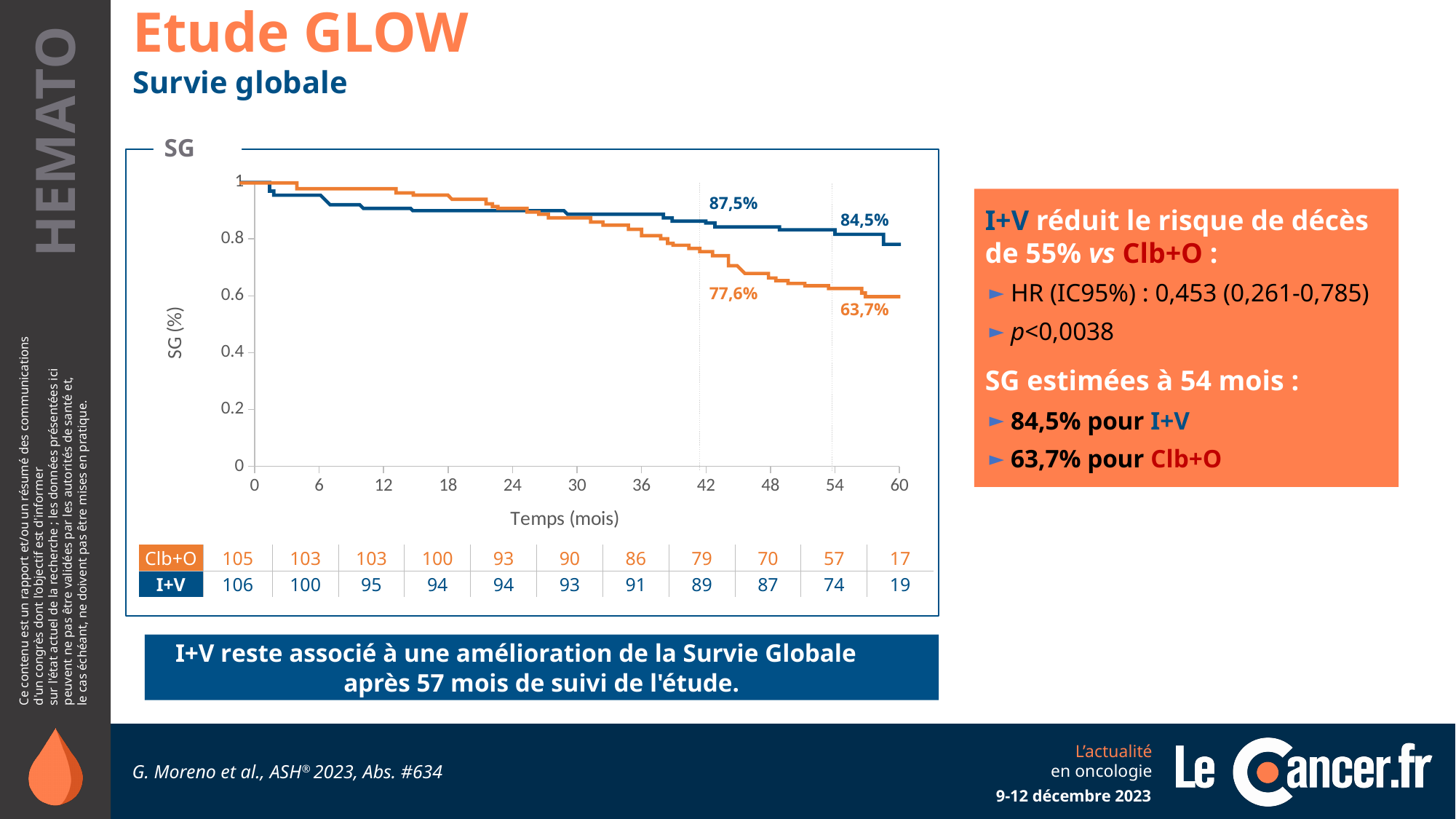
What is the label of the x axis of the chart? Temps (mois) What is the labelled survival value for I+V at the first dotted line (around 42 months)? 87,5% What is the labelled survival value for Clb+O at the first dotted line (around 42 months)? 77,6% How many series are plotted on the chart? 2 How many patients at risk are listed for Clb+O at 0 months in the table below the chart? 105 Do the survival curves rise or fall as time (months) increases? fall Which series has the higher survival at 54 months, I+V or Clb+O? I+V What kind of chart is shown on the slide? line chart Is the Clb+O survival curve at 60 months greater or less than 0.8? less What is the difference between the I+V and Clb+O survival values labelled at 54 months? 20,8% What is the estimated overall survival (SG) for I+V at 54 months, as labelled on the chart? 84,5% What is the estimated overall survival (SG) for Clb+O at 54 months, as labelled on the chart? 63,7%